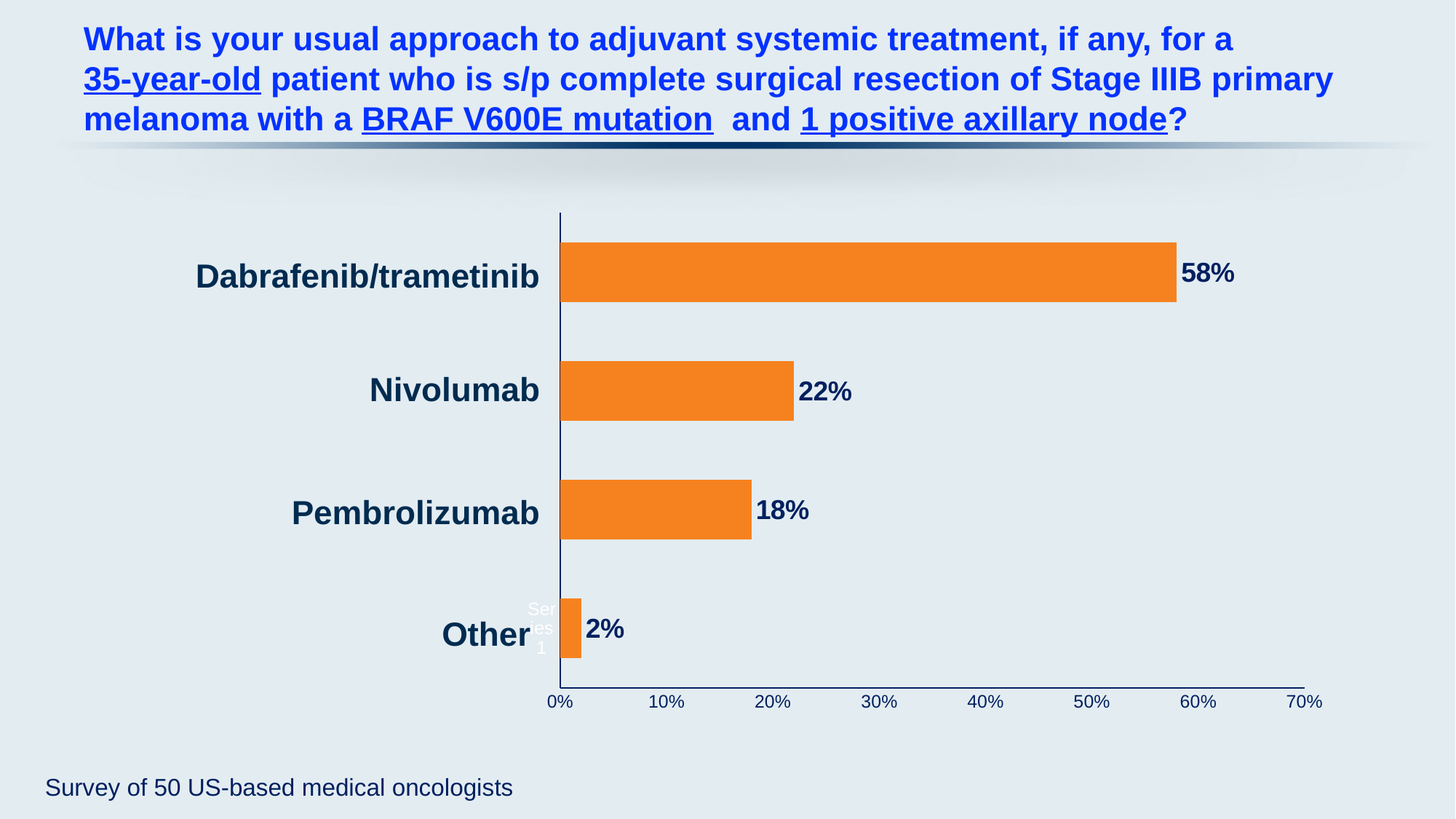
How many treatment categories are shown in the chart? 4 What type of chart is shown on the slide? Bar chart What percentage of respondents chose Pembrolizumab? 18% Which category has the lowest percentage? Other Which has a larger percentage, Nivolumab or Pembrolizumab? Nivolumab Is the value for Dabrafenib/trametinib greater or less than 50%? greater What percentage of respondents chose Dabrafenib/trametinib? 58% Which treatment option has the highest percentage? Dabrafenib/trametinib What is the difference in percentage points between Nivolumab and Pembrolizumab? 4 What percentage of respondents chose Nivolumab? 22% What is the difference in percentage points between Dabrafenib/trametinib and Nivolumab? 36 What percentage of respondents chose Other? 2%